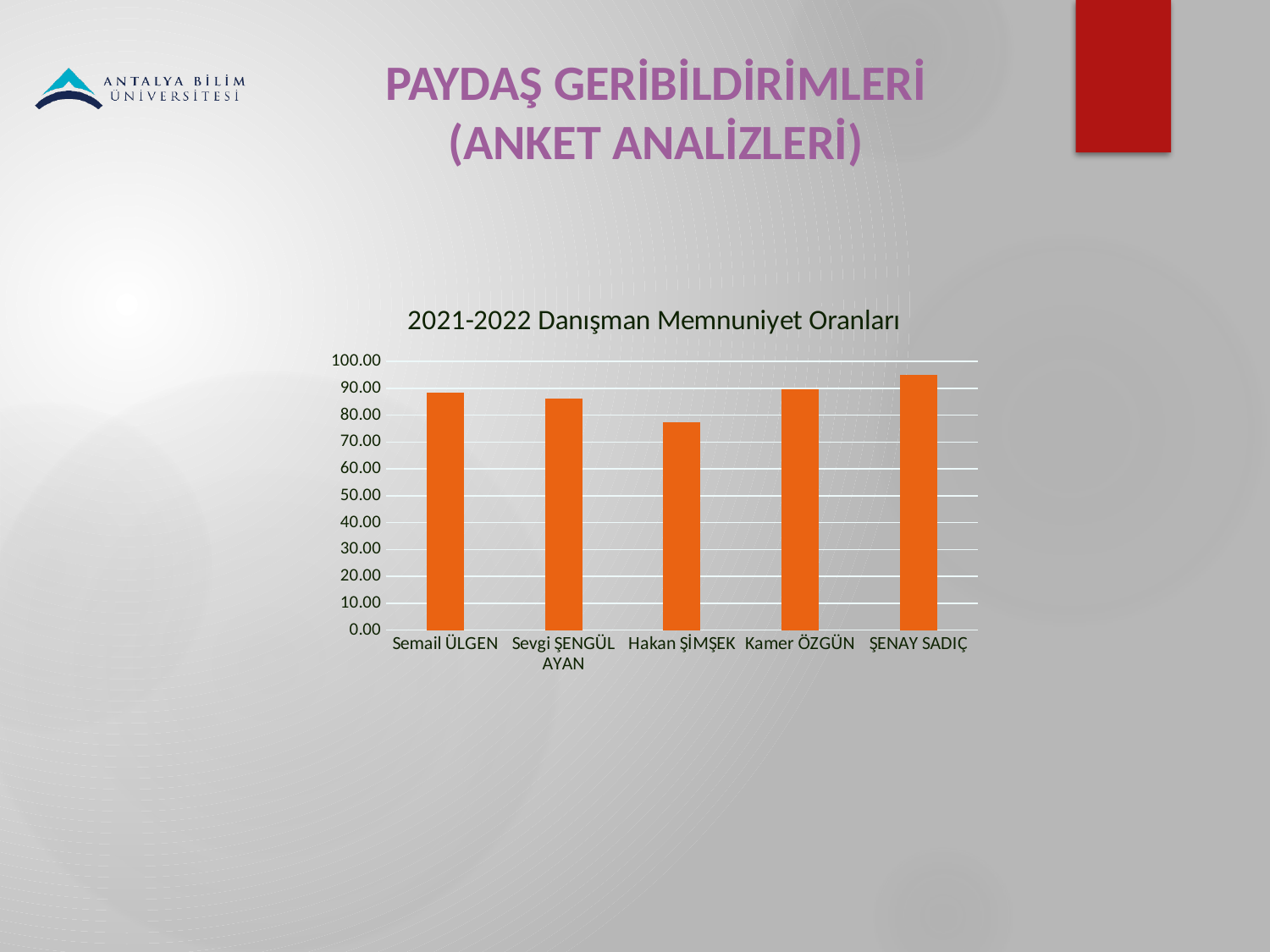
Which is larger, the value for Kamer ÖZGÜN or the value for Hakan ŞİMŞEK? Kamer ÖZGÜN Is the value for ŞENAY SADIÇ greater or less than 90.00? greater What is the maximum value shown on the vertical axis of the chart? 100.00 Is the value for Kamer ÖZGÜN greater or less than 80.00? greater Which advisor has the lowest satisfaction rate in the chart? Hakan ŞİMŞEK What is the title of the chart? 2021-2022 Danışman Memnuniyet Oranları What type of chart is shown on the slide? bar chart Is the value for Semail ÜLGEN greater or less than 80.00? greater How many categories (advisors) are shown in the chart? 5 Which advisor has the highest satisfaction rate in the chart? ŞENAY SADIÇ